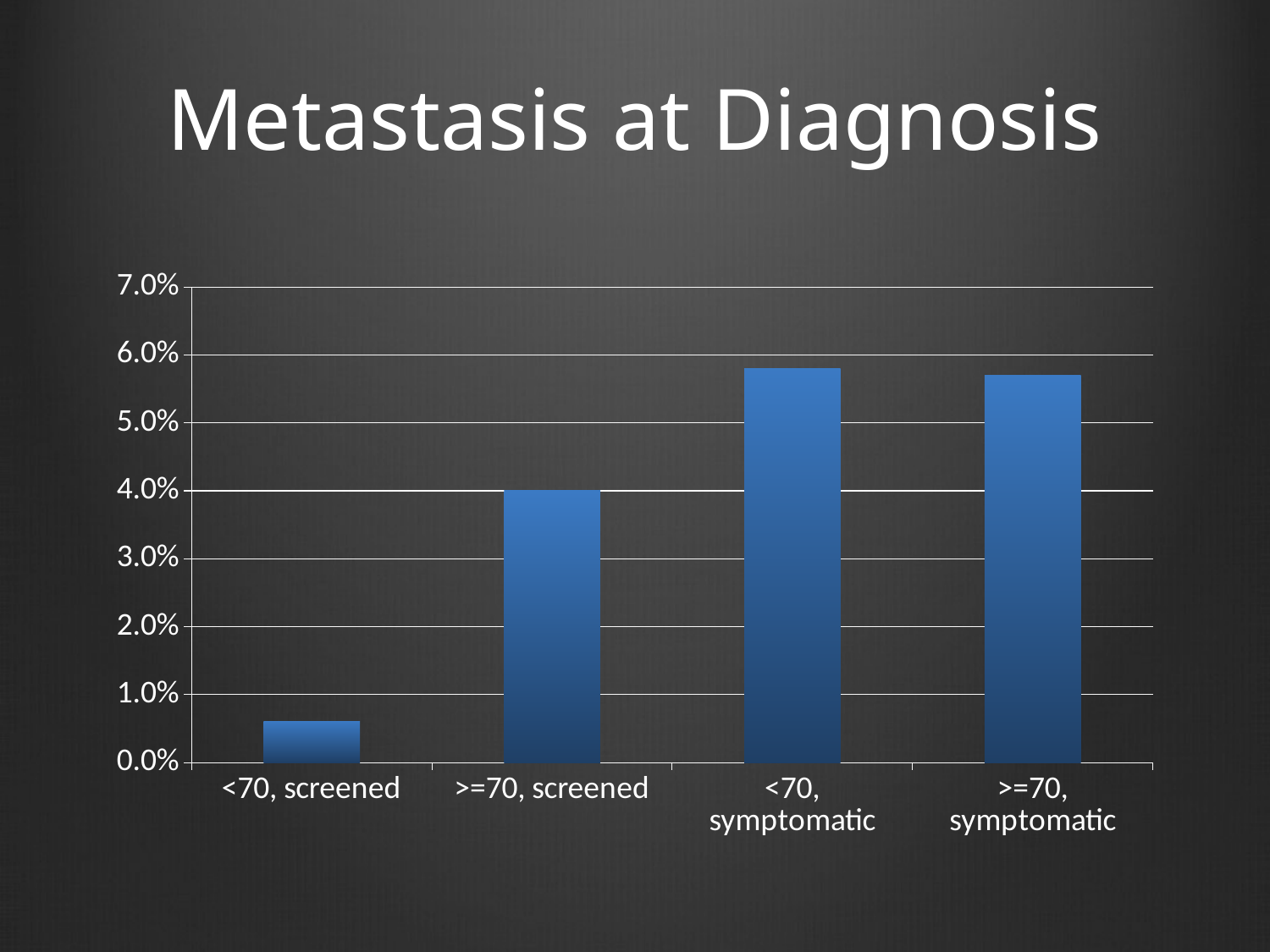
Which is larger, the value for <70, screened or the value for >=70, screened? >=70, screened Is the value for >=70, symptomatic greater or less than 6.0%? less What kind of chart is shown on the slide? bar chart Which is larger, the value for >=70, screened or the value for <70, symptomatic? <70, symptomatic Is the value for <70, screened greater or less than 1.0%? less What is the title of the chart? Metastasis at Diagnosis What is the value for >=70, screened? 4.0% What is the highest value shown on the y axis? 7.0% Is the value for <70, symptomatic greater or less than 5.0%? greater How many categories are shown on the x axis? 4 Which category has the lowest value? <70, screened